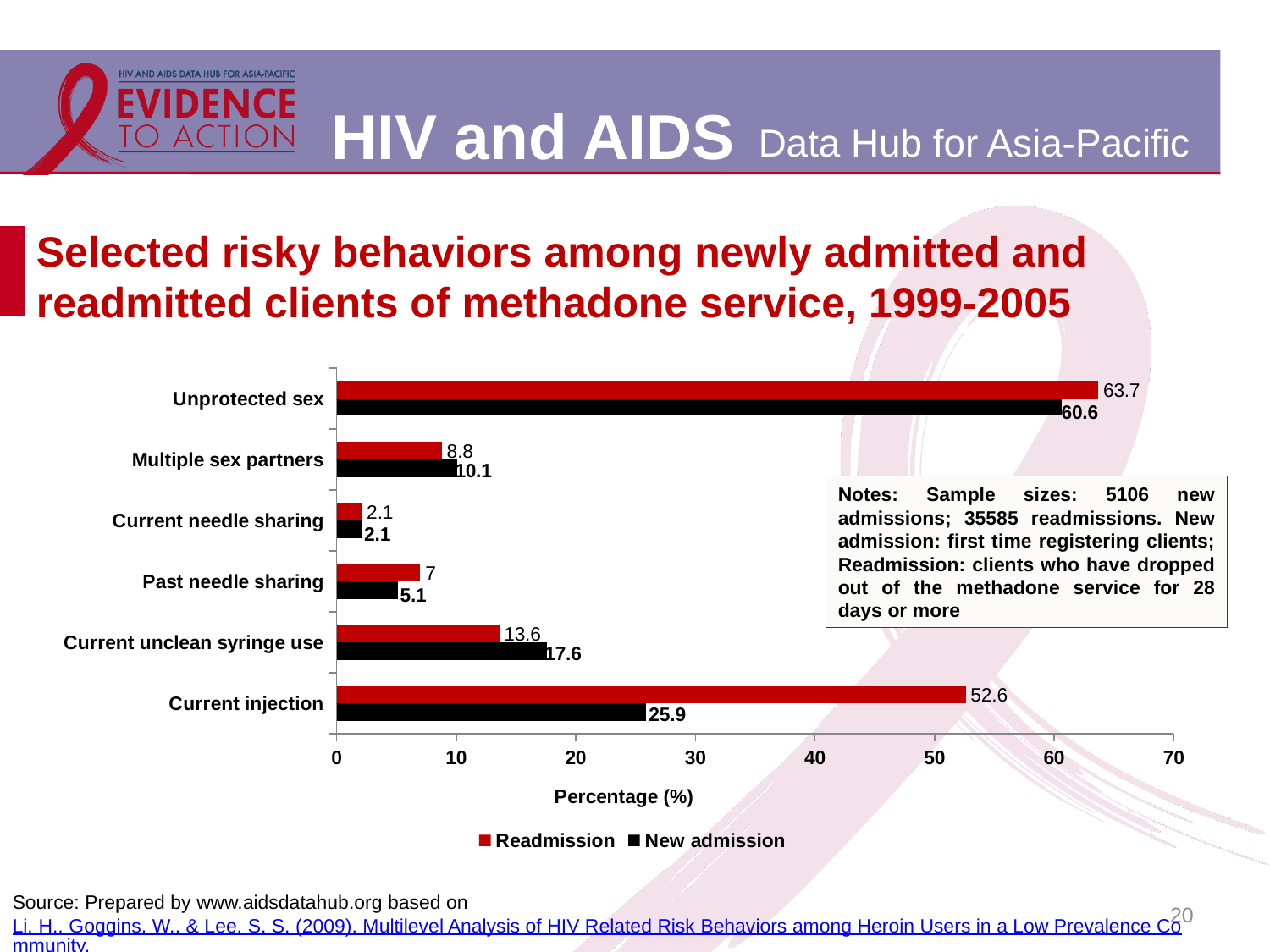
What is the Readmission value for Unprotected sex? 63.7 What is the New admission value for Current unclean syringe use? 17.6 What is the difference between the Readmission and New admission values for Current injection? 26.7 What is the label of the horizontal axis? Percentage (%) What kind of chart is shown on the slide? Bar chart Which category has the lowest New admission value? Current needle sharing How many risky behavior categories are shown on the chart? 6 How many series does the legend list? 2 Which is larger for Multiple sex partners: the Readmission value or the New admission value? New admission What is the New admission value for Current injection? 25.9 Which category has the highest Readmission value? Unprotected sex Is the Readmission value for Current injection greater or less than 50? greater